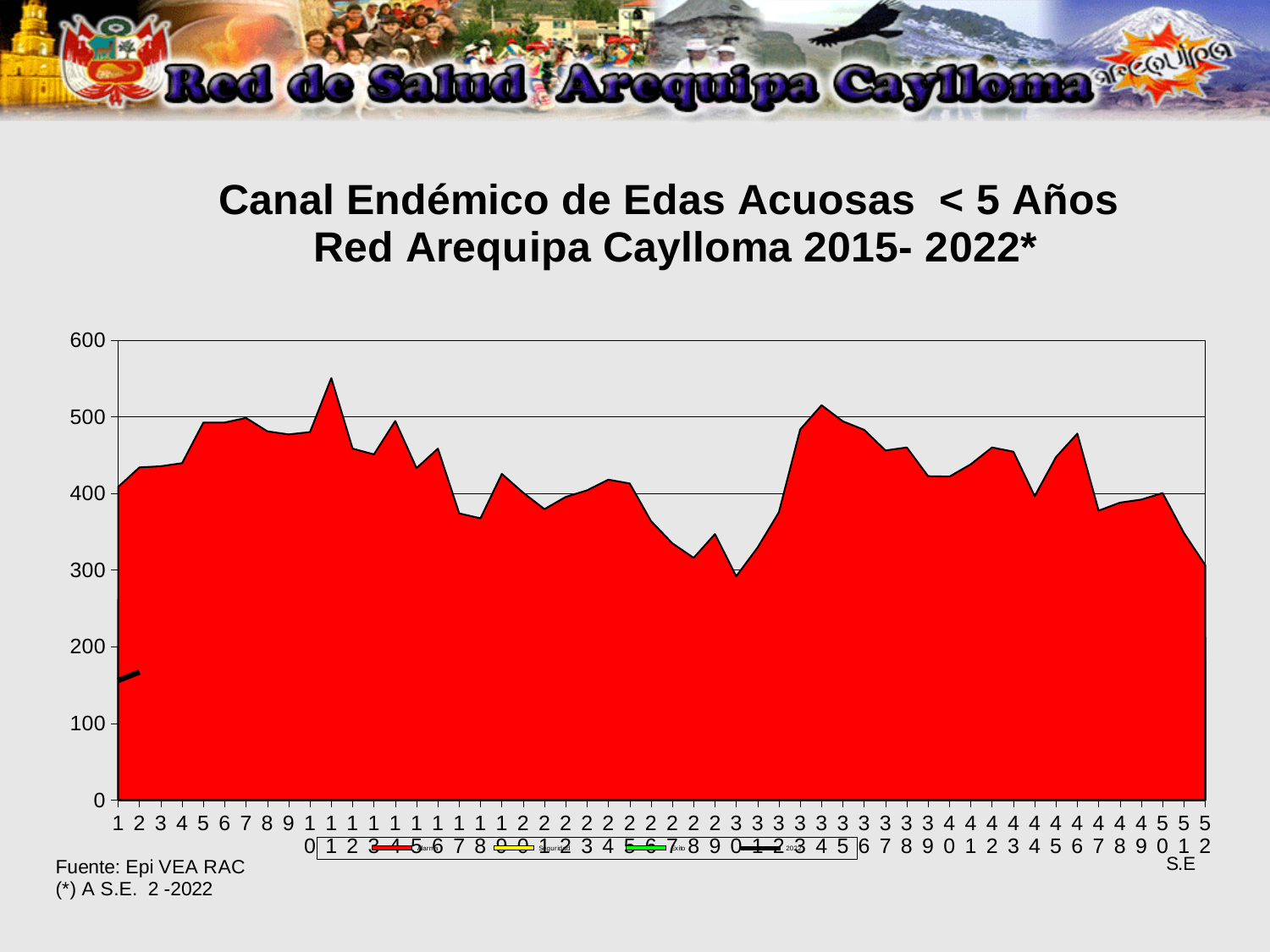
Is the value of the red area at week 46 greater or less than 400? greater How many epidemiological weeks (S.E.) are shown along the x axis? 52 Is the value of the red area at week 28 greater or less than 400? less What kind of chart is shown on the slide? Area chart Is the value of the red area at week 20 greater or less than 300? greater At which week does the red area reach its highest point? Week 11 Does the red area rise or fall from week 46 to week 52? Fall Does the red area rise or fall from week 1 to week 11? Rise What is the highest value shown on the vertical axis? 600 What is the title of the chart? Canal Endémico de Edas Acuosas < 5 Años Red Arequipa Caylloma 2015- 2022*